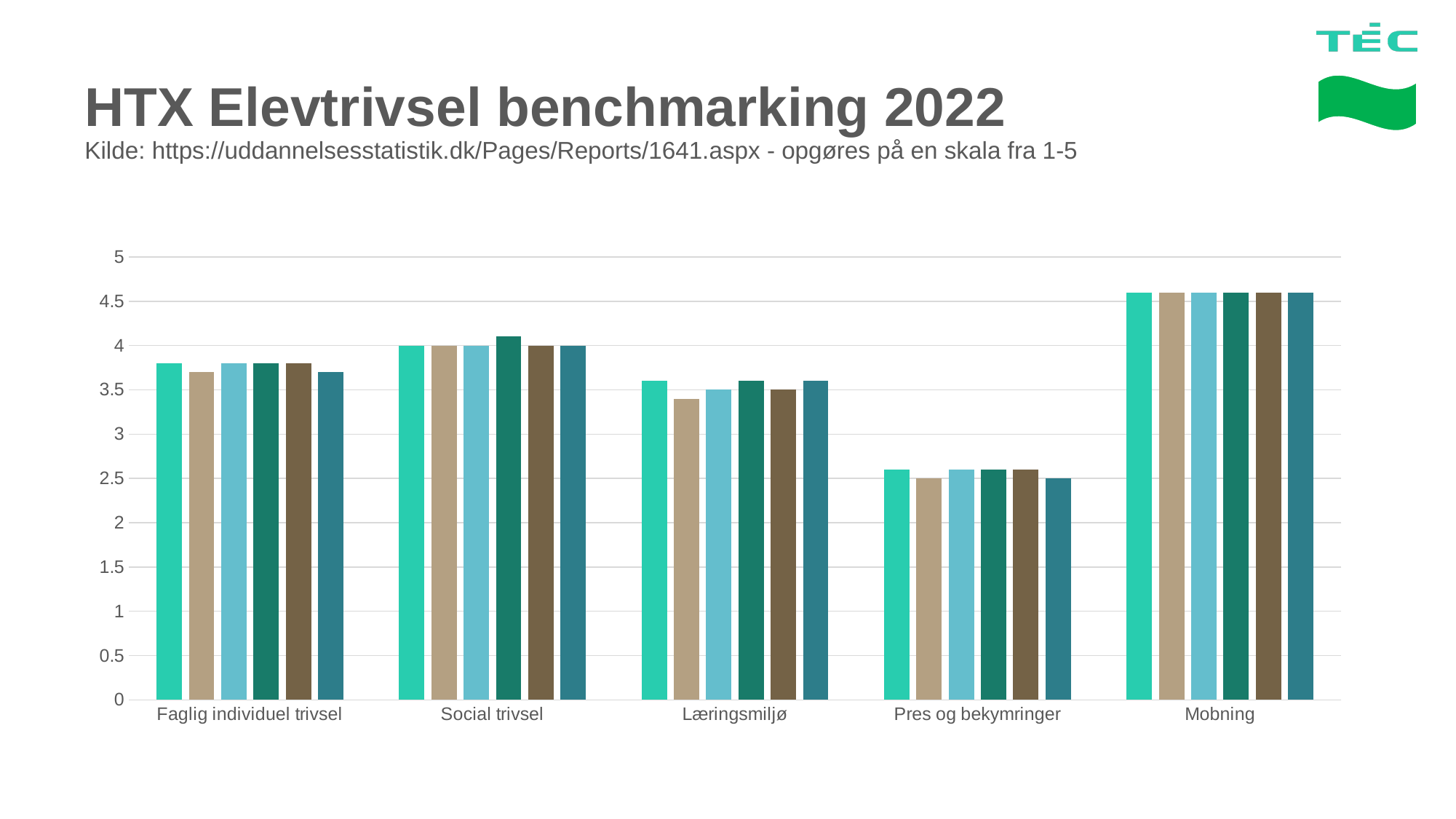
How many categories are shown on the x axis of the chart? 5 What is the title of the slide containing the chart? HTX Elevtrivsel benchmarking 2022 How many bars are plotted for each category in the chart? 6 Are the values for Faglig individuel trivsel greater or less than 3.5? greater Which category has the highest values in the chart? Mobning What value does the leftmost (bright green) bar for Social trivsel reach? 4 Which category has higher values, Social trivsel or Læringsmiljø? Social trivsel What kind of chart is shown on the slide? bar chart Are the values for Mobning greater or less than 4? greater Which category has the lowest values in the chart? Pres og bekymringer Are the values for Læringsmiljø greater or less than 4? less